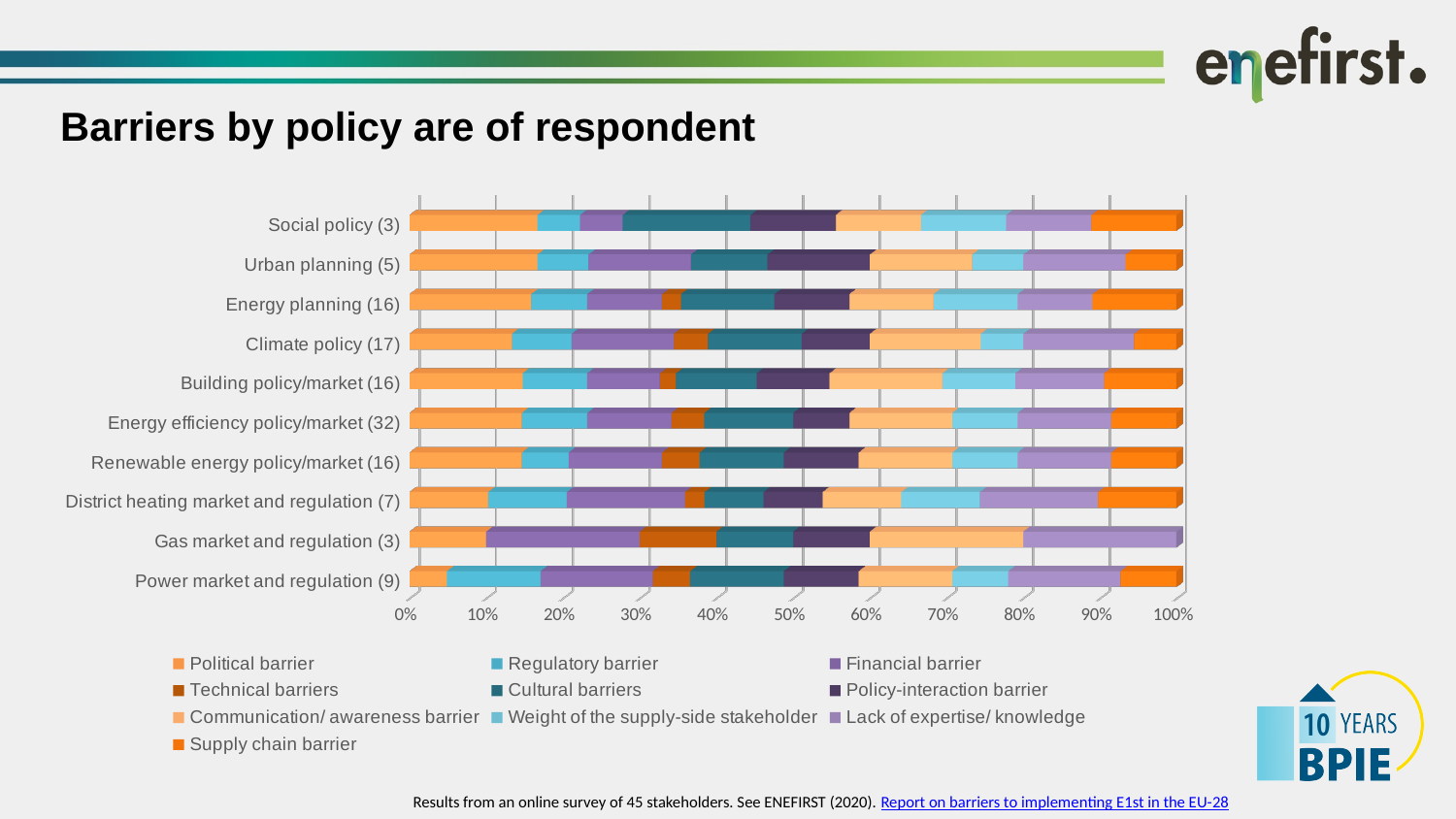
What kind of chart is shown on the slide? Stacked bar chart Which category has the smallest Political barrier segment? Power market and regulation (9) How many respondents are indicated in the label for Climate policy? 17 What is the maximum value shown on the x axis? 100% What is the title of the chart slide? Barriers by policy are of respondent How many respondents are indicated in the label for Energy efficiency policy/market? 32 Is the Political barrier share for Energy planning (16) greater or less than 10%? greater Which series is listed first in the legend? Political barrier Is the Political barrier share for Power market and regulation (9) greater or less than 10%? less Is the Political barrier share for Social policy (3) greater or less than 10%? greater How many policy-area categories are plotted on the y axis? 10 How many series does the legend list? 10